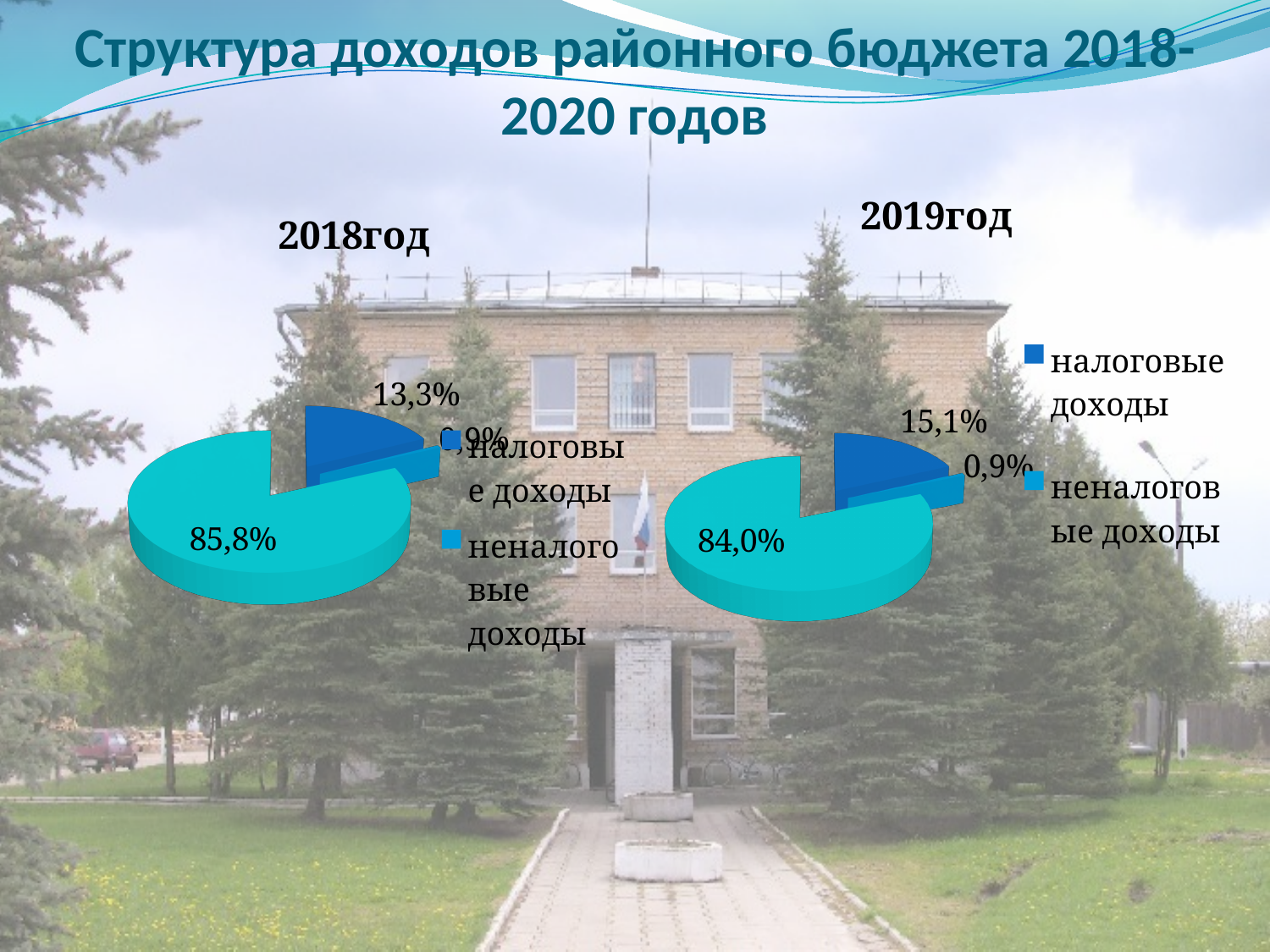
How many entries does the legend of the 2019год chart list? 2 Which chart has the larger largest slice, 2018год (85,8%) or 2019год (84,0%)? 2018год In the 2018год chart, what is the value of the dark blue slice labelled next to the largest slice? 13,3% How many slices does the 2019год pie chart have? 3 How many pie charts are shown on the slide? 2 What is the difference between the largest slice in the 2018год chart (85,8%) and the largest slice in the 2019год chart (84,0%)? 1,8% In the 2019год chart, what is the value of the smallest slice? 0,9% In the 2018год chart, what is the value of the largest slice? 85,8% What is the difference between the dark blue slice in the 2019год chart (15,1%) and the dark blue slice in the 2018год chart (13,3%)? 1,8% In the 2019год chart, what is the value of the dark blue slice? 15,1% In the 2019год chart, what is the value of the largest slice? 84,0% What kind of chart is used for the 2018год chart? pie chart